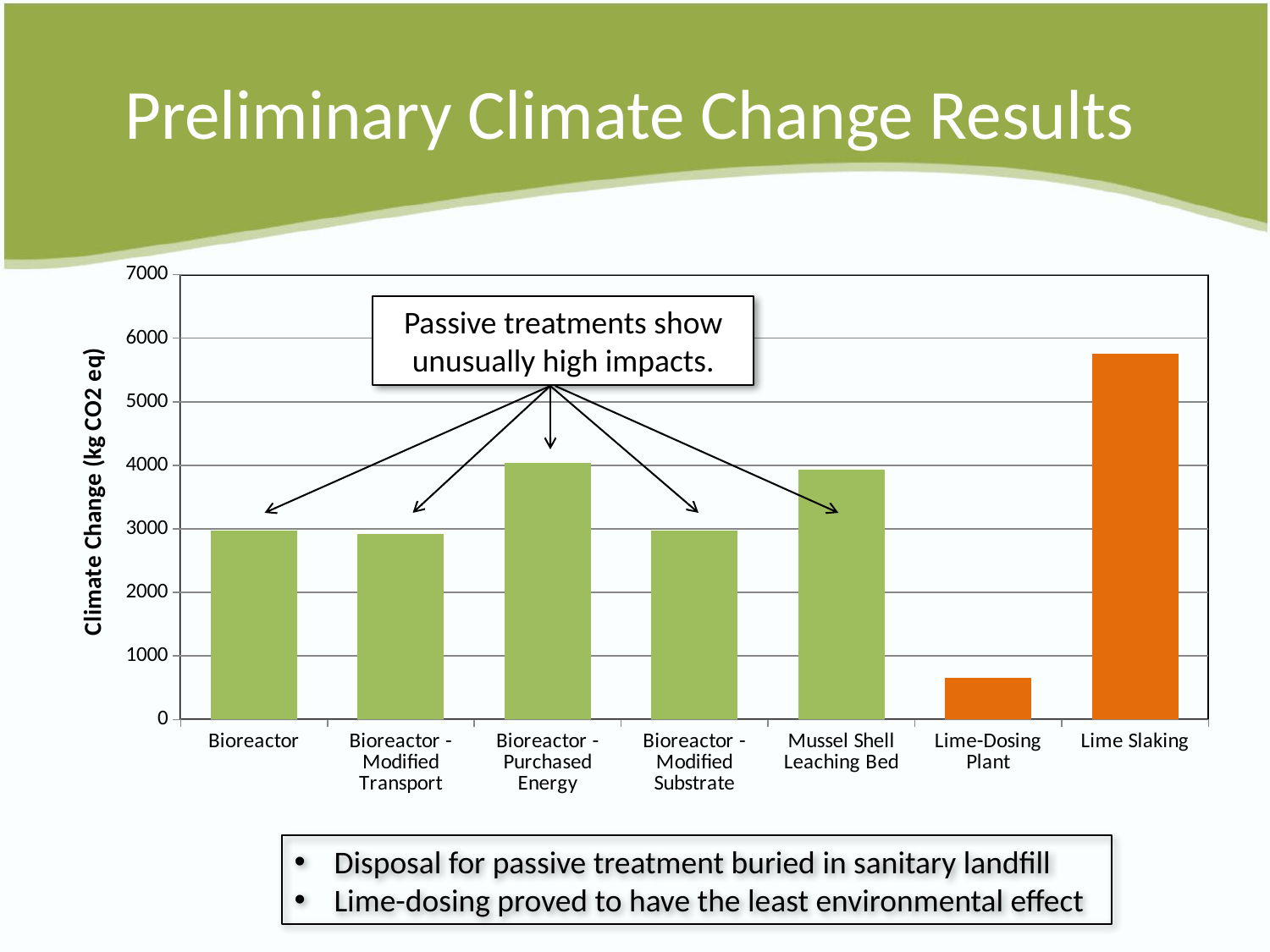
Is the value for Mussel Shell Leaching Bed greater or less than 3000? greater Which is larger, the value for Mussel Shell Leaching Bed or the value for Lime-Dosing Plant? Mussel Shell Leaching Bed Is the value for Lime Slaking greater or less than 5000? greater Which category has the highest climate change value? Lime Slaking Which is larger, the value for Lime Slaking or the value for Bioreactor - Purchased Energy? Lime Slaking How many categories are plotted on the x axis of the chart? 7 What is the label of the y axis of the chart? Climate Change (kg CO2 eq) Is the value for Lime-Dosing Plant greater or less than 1000? less Which category has the lowest climate change value? Lime-Dosing Plant What kind of chart is shown on the slide? bar chart